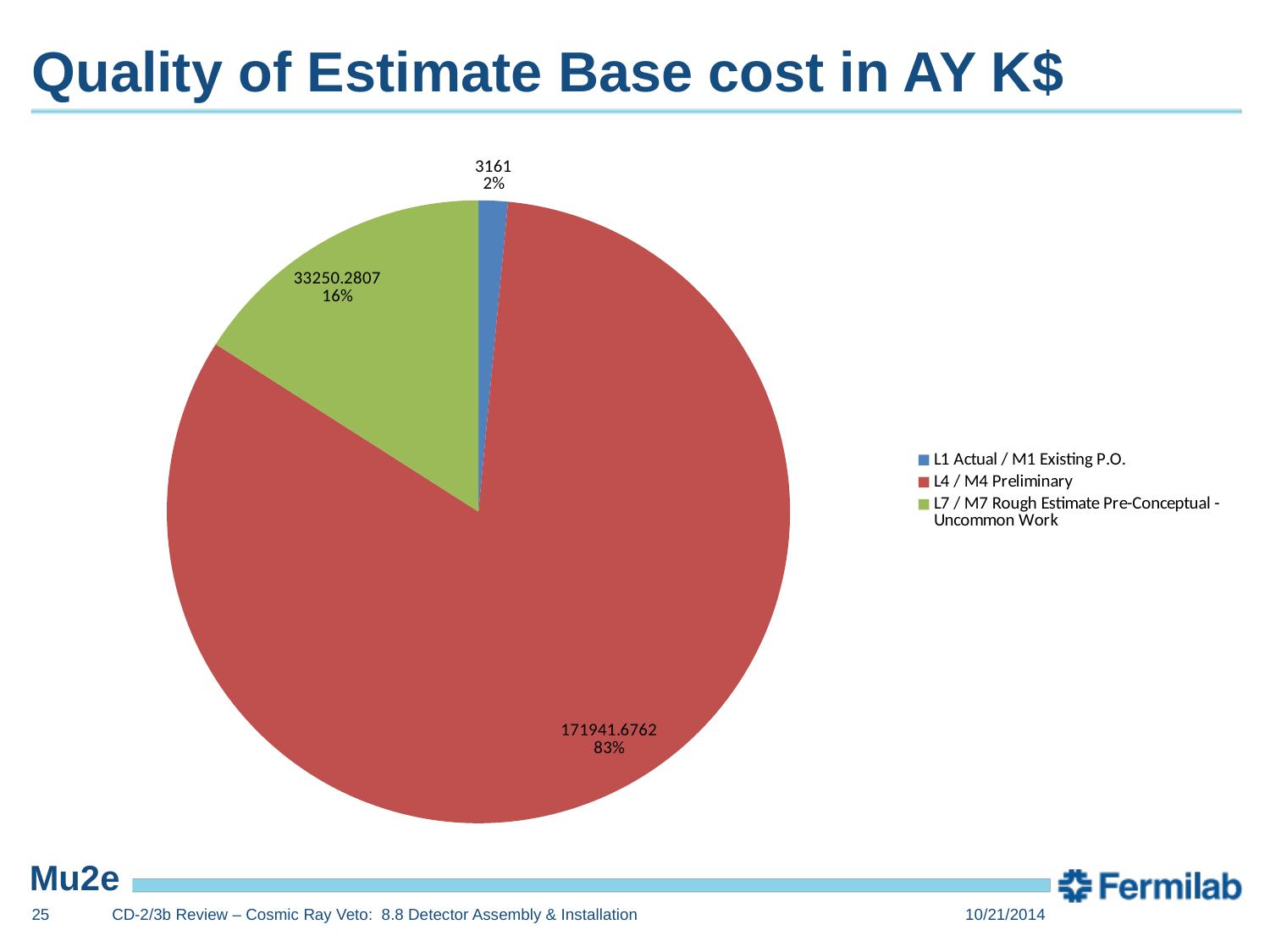
What is the title of the chart on the slide? Quality of Estimate Base cost in AY K$ What is the value for L1 Actual / M1 Existing P.O.? 3161 Which category has the smallest slice of the pie? L1 Actual / M1 Existing P.O. What is the value for L7 / M7 Rough Estimate Pre-Conceptual - Uncommon Work? 33250.2807 What share of the pie does L4 / M4 Preliminary represent? 83% What is the value for L4 / M4 Preliminary? 171941.6762 Which is larger, the slice for L7 / M7 Rough Estimate Pre-Conceptual - Uncommon Work or the slice for L1 Actual / M1 Existing P.O.? L7 / M7 Rough Estimate Pre-Conceptual - Uncommon Work What share of the pie does L7 / M7 Rough Estimate Pre-Conceptual - Uncommon Work represent? 16% How many categories does the pie chart have? 3 What share of the pie does L1 Actual / M1 Existing P.O. represent? 2% Which category has the largest slice of the pie? L4 / M4 Preliminary What kind of chart is shown on the slide? pie chart